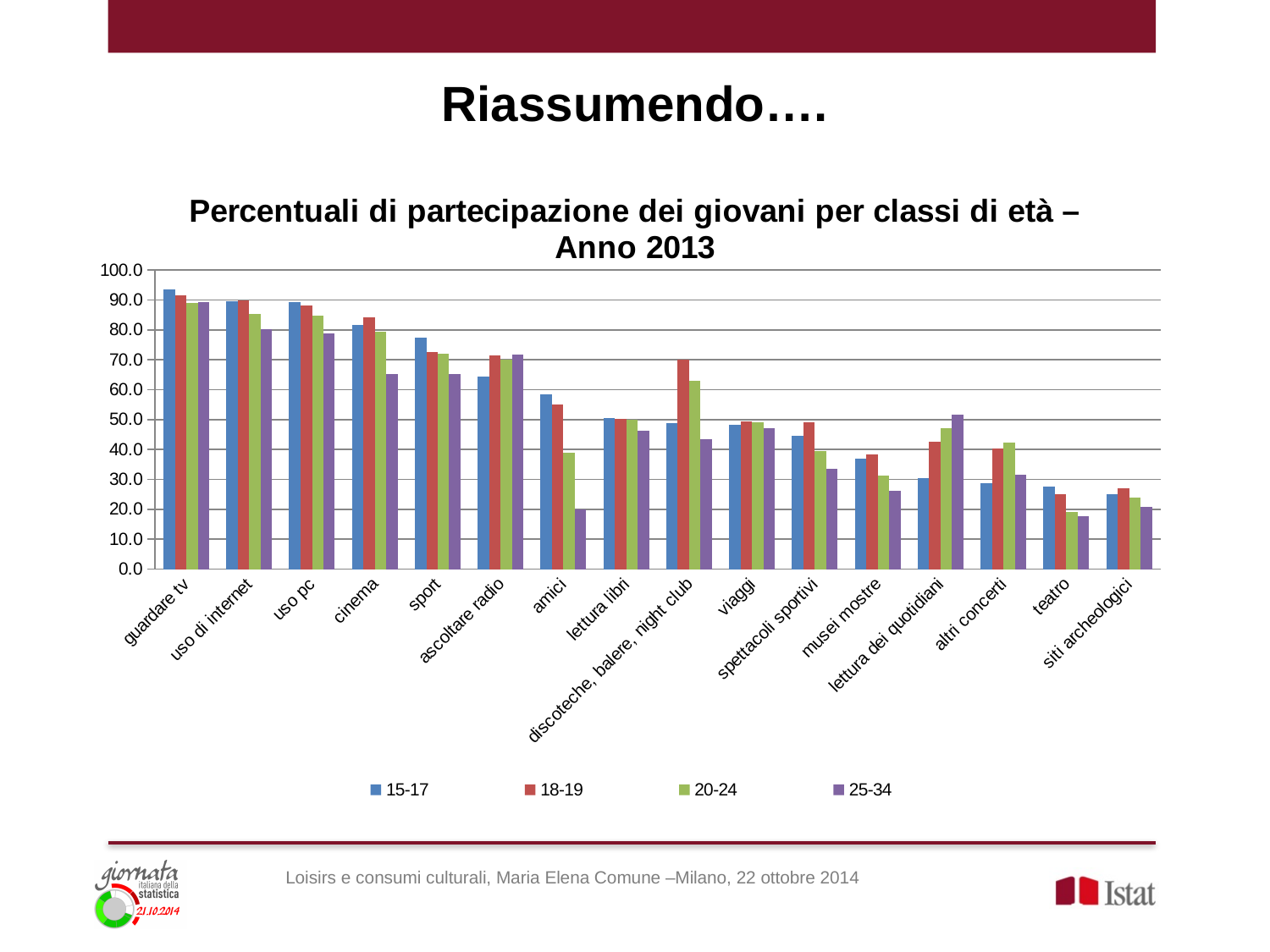
Is the value for guardare tv in the 15-17 series greater or less than 90.0? greater How many activity categories are shown on the x axis? 16 What kind of chart is shown on the slide? bar chart Is the value for musei mostre in the 25-34 series greater or less than 30.0? less Which activity has the highest value for the 15-17 age group? guardare tv For amici, which age group has the larger value: 15-17 or 25-34? 15-17 For lettura dei quotidiani, which age group has the larger value: 15-17 or 25-34? 25-34 Is the value for siti archeologici in the 15-17 series greater or less than 20.0? greater How many series does the legend list? 4 What is the title of the chart? Percentuali di partecipazione dei giovani per classi di età – Anno 2013 For discoteche, balere, night club, which age group has the larger value: 15-17 or 18-19? 18-19